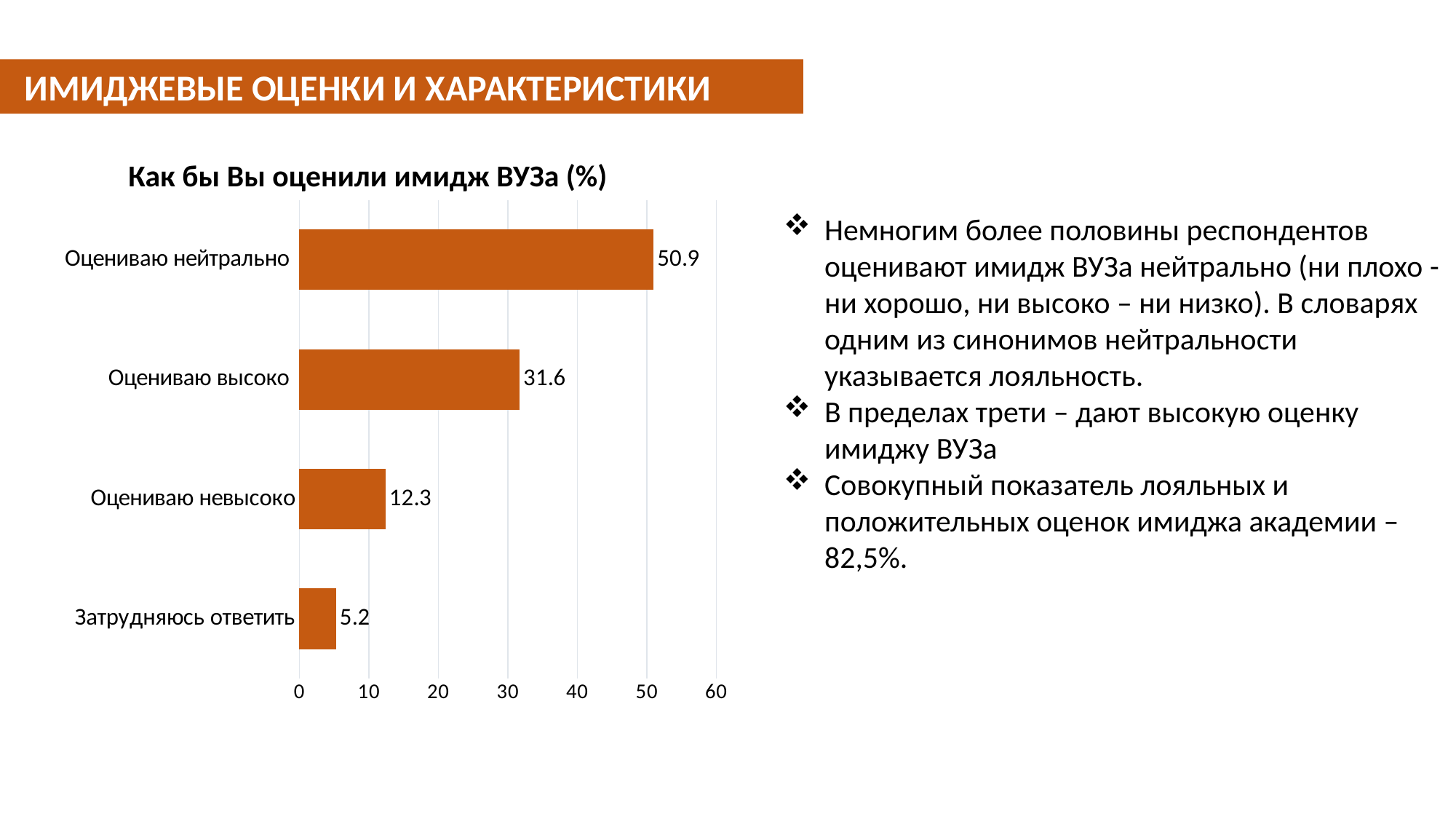
What is the title of the chart? Как бы Вы оценили имидж ВУЗа (%) Which category has the lowest value? Затрудняюсь ответить Is the value for "Оцениваю высоко" greater or less than 40? less What is the value for "Оцениваю невысоко"? 12.3 What is the value for "Оцениваю высоко"? 31.6 What is the value for "Оцениваю нейтрально"? 50.9 What is the difference between the values for "Оцениваю нейтрально" and "Оцениваю высоко"? 19.3 Which category has the highest value? Оцениваю нейтрально What is the value for "Затрудняюсь ответить"? 5.2 How many categories are shown in the chart? 4 What kind of chart is shown on the slide? bar chart Which is larger, the value for "Оцениваю невысоко" or the value for "Затрудняюсь ответить"? Оцениваю невысоко